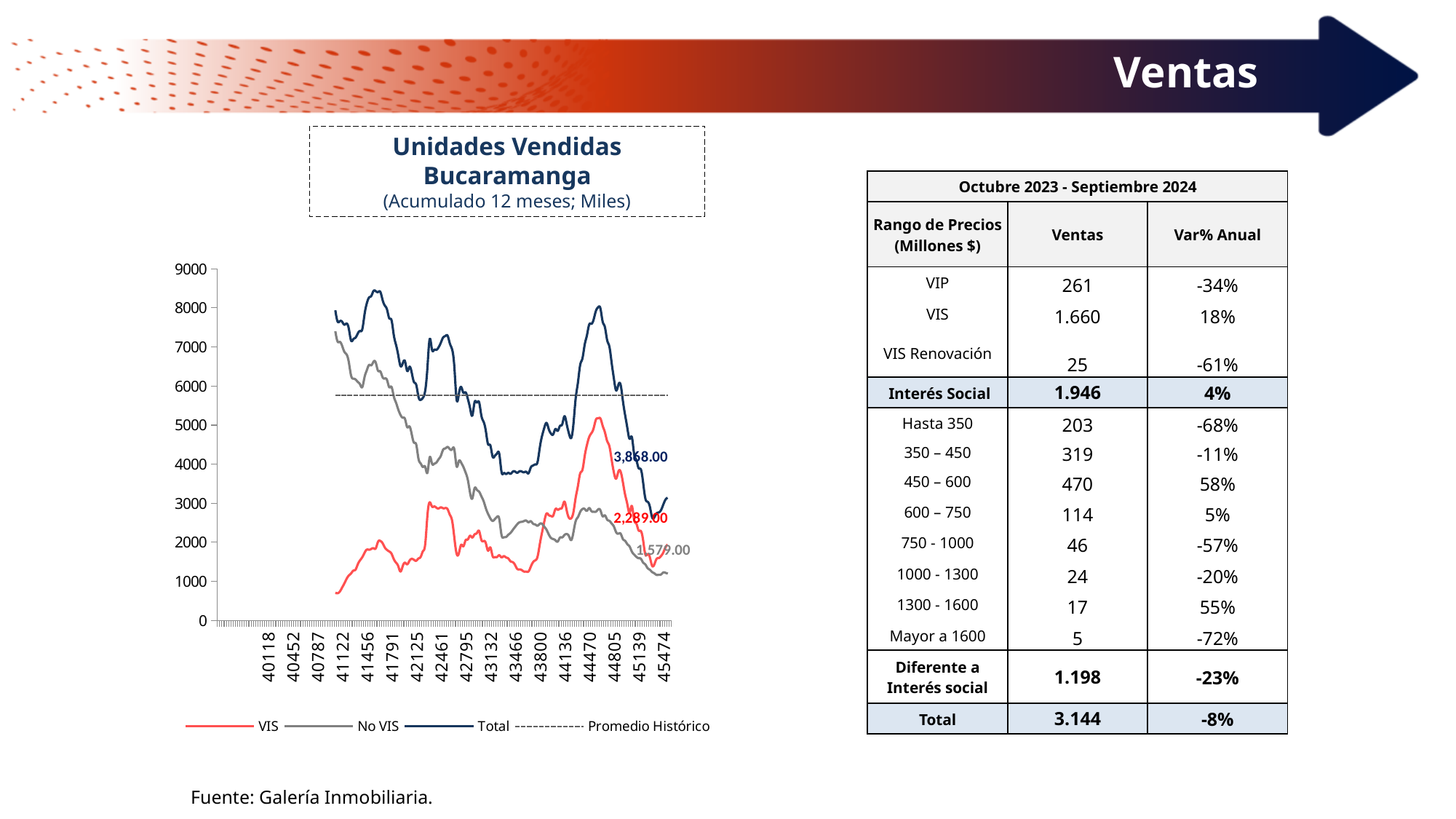
Is the Promedio Histórico dashed line in the "Unidades Vendidas Bucaramanga" chart greater or less than 5000? greater In the "Unidades Vendidas Bucaramanga" chart, does the Total series end higher or lower than where it starts? lower What is the labelled final value of the VIS series in the "Unidades Vendidas Bucaramanga" chart? 2,289.00 At the end of the period in the "Unidades Vendidas Bucaramanga" chart, which is higher, the VIS line or the No VIS line? VIS What colour is the Total line in the "Unidades Vendidas Bucaramanga" chart? dark blue What is the labelled final value of the Total series in the "Unidades Vendidas Bucaramanga" chart? 3,868.00 Is the highest point of the Total series in the "Unidades Vendidas Bucaramanga" chart greater or less than 8000? greater In the "Unidades Vendidas Bucaramanga" chart, which series has the highest labelled value at the end of the period? Total What kind of chart is shown under the title "Unidades Vendidas Bucaramanga"? line chart How many series does the legend of the "Unidades Vendidas Bucaramanga" chart list? 4 In the "Unidades Vendidas Bucaramanga" chart, which series has the lowest labelled value at the end of the period? No VIS In the "Unidades Vendidas Bucaramanga" chart, what is the difference between the labelled Total value (3,868.00) and the labelled VIS value (2,289.00)? 1,579.00